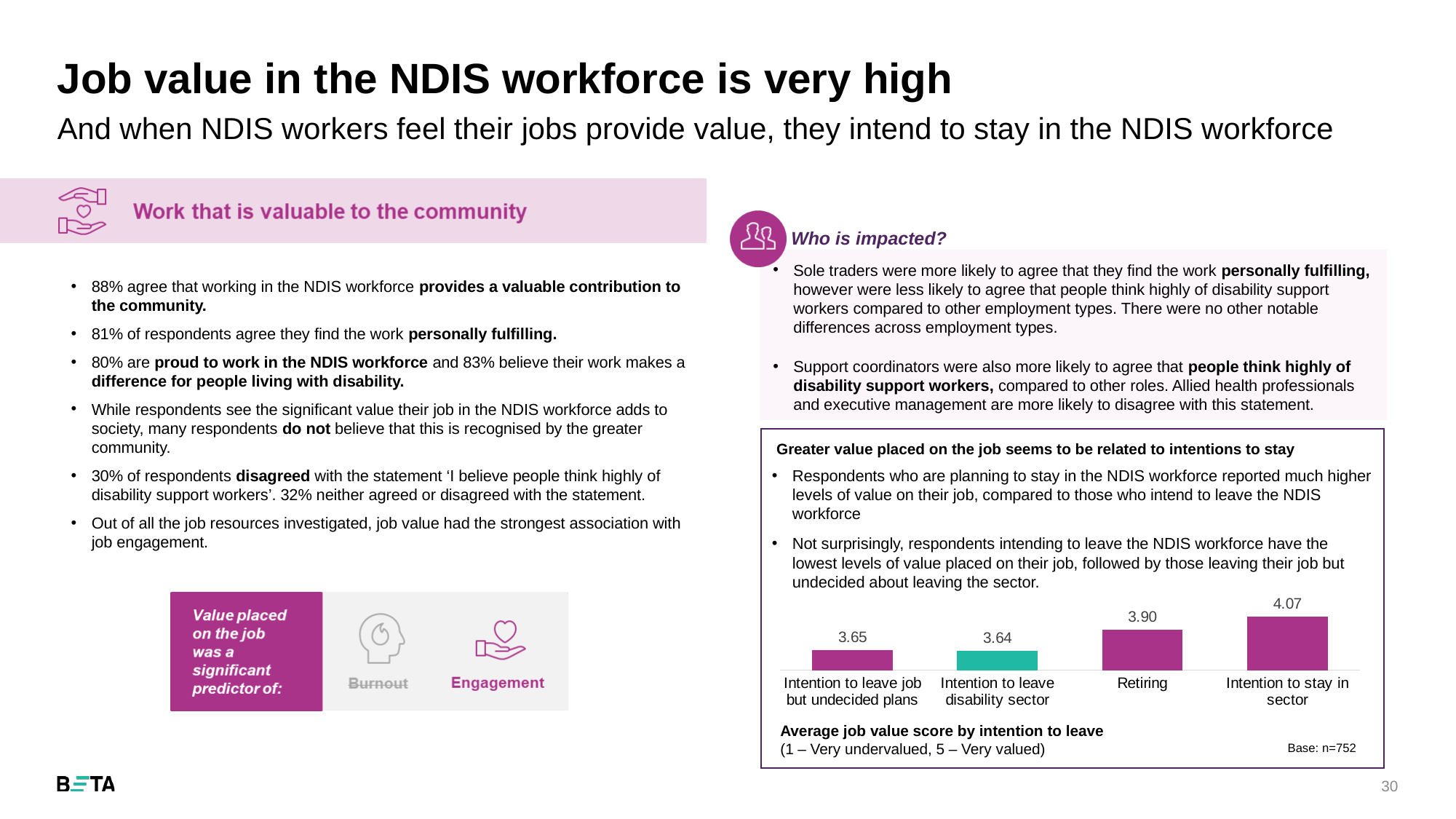
Which has a higher average job value score: 'Retiring' or 'Intention to leave disability sector'? Retiring What is the title of the chart on the slide? Average job value score by intention to leave What is the average job value score for respondents with an intention to leave the disability sector? 3.64 What is the average job value score for respondents who are retiring? 3.90 What is the average job value score for respondents with an intention to stay in the sector? 4.07 Which intention category has the highest average job value score? Intention to stay in sector How many intention categories are shown in the chart? 4 What is the base sample size stated for the chart? n=752 What is the difference between the average job value score for 'Intention to stay in sector' and 'Intention to leave job but undecided plans'? 0.42 What is the average job value score for respondents with an intention to leave their job but undecided plans? 3.65 What is the difference between the average job value score for 'Intention to stay in sector' and 'Retiring'? 0.17 What type of chart is used to show average job value score by intention to leave? Bar chart